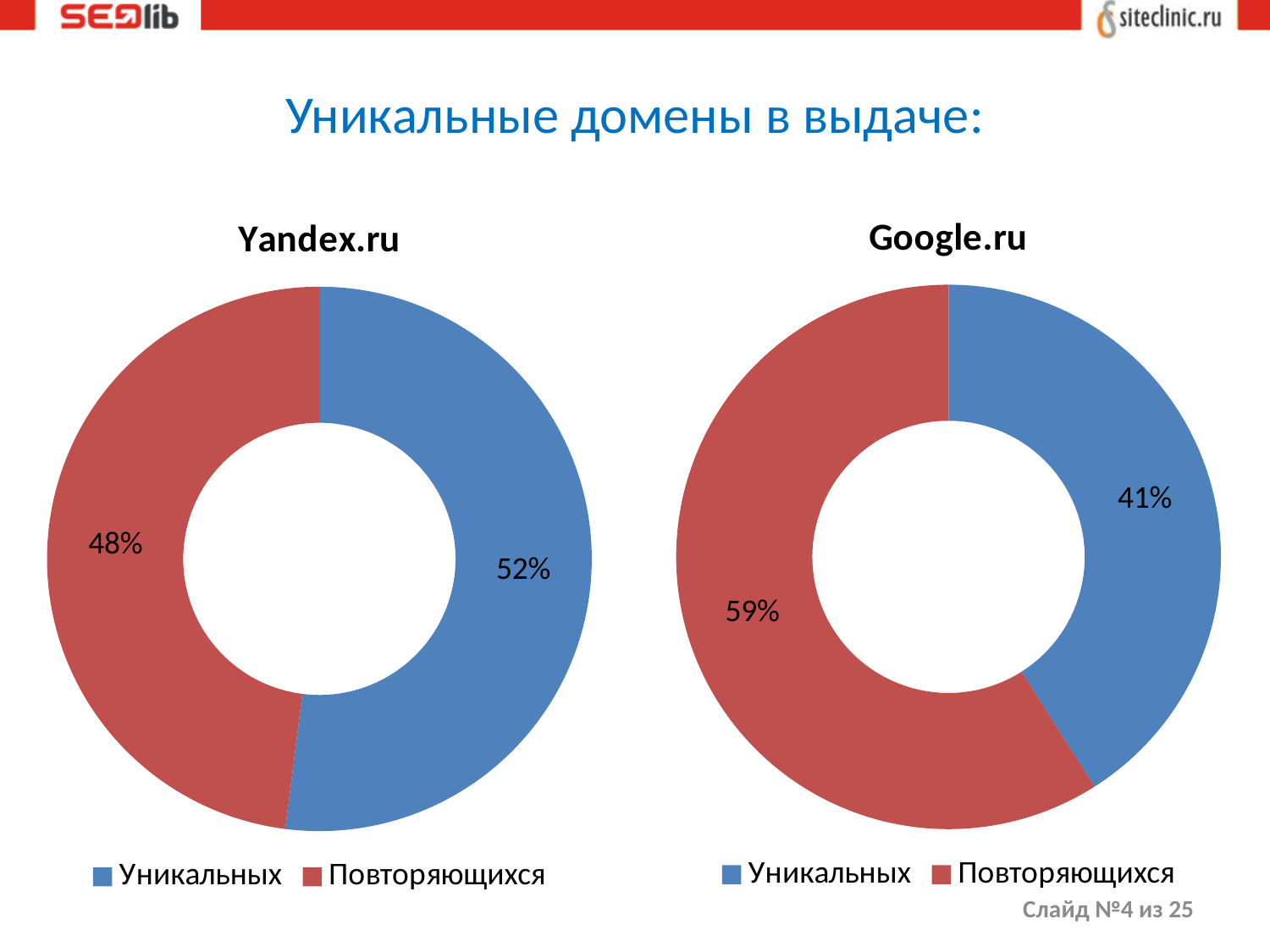
In the Yandex.ru chart, what is the value for Уникальных? 52% In the Google.ru chart, what colour is the Повторяющихся slice? red In the Google.ru chart, what is the value for Повторяющихся? 59% In the Yandex.ru chart, what is the value for Повторяющихся? 48% In the Google.ru chart, what is the value for Уникальных? 41% How many categories does the Google.ru chart show? 2 In the Google.ru chart, which category has the largest share? Повторяющихся Which is larger: Уникальных in the Yandex.ru chart or Уникальных in the Google.ru chart? Yandex.ru In the Yandex.ru chart, what is the difference between Уникальных and Повторяющихся? 4% In the Google.ru chart, what is the difference between Повторяющихся and Уникальных? 18% What kind of chart is the Yandex.ru chart? doughnut chart In the Yandex.ru chart, which category has the smallest share? Повторяющихся